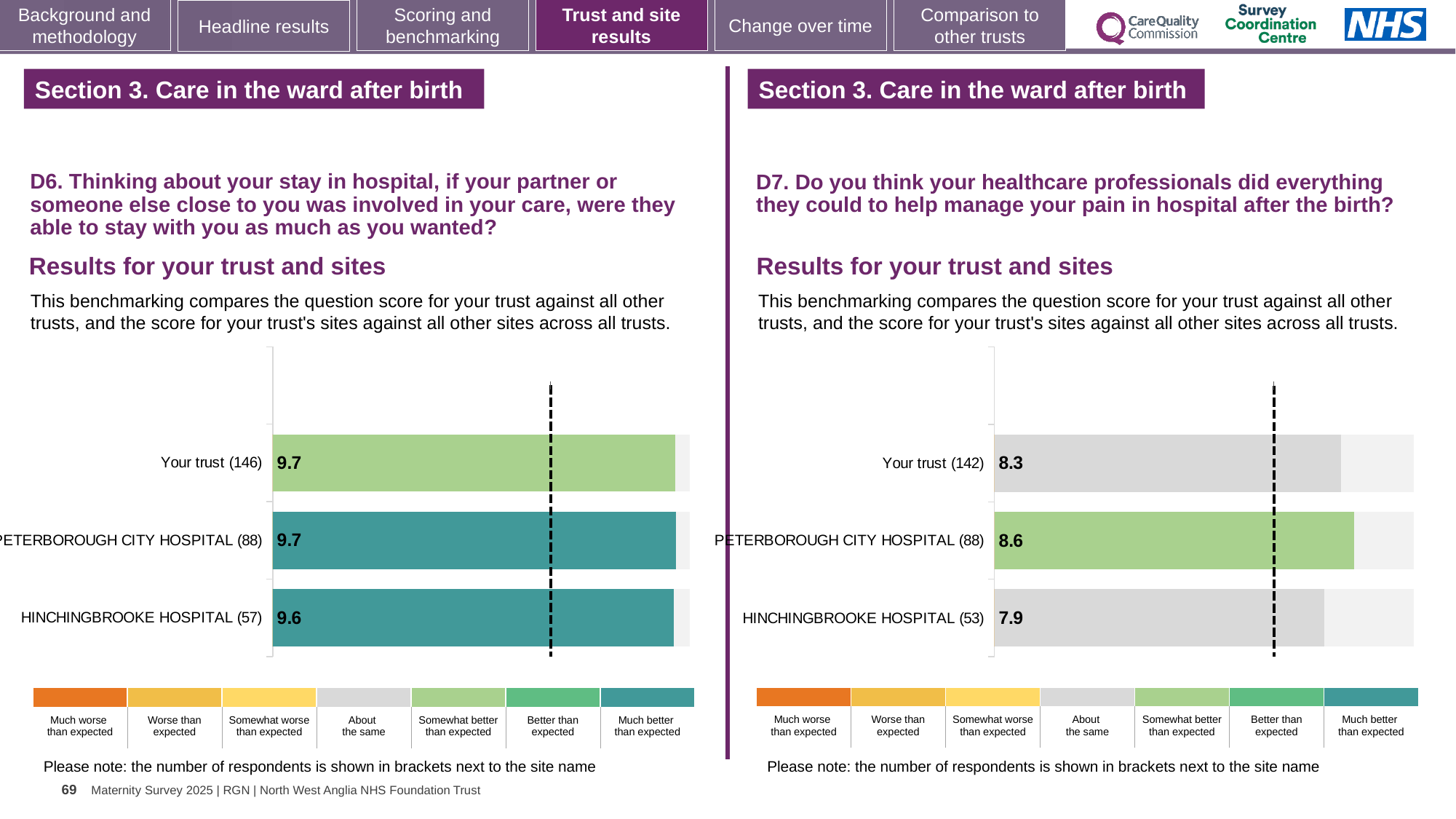
On the left chart (D6), which site has the lowest score? HINCHINGBROOKE HOSPITAL (57) On the right chart (D7), what is the score for Your trust (142)? 8.3 On the left chart (D6), what is the score for Your trust (146)? 9.7 How many bars are plotted on the left chart (D6)? 3 On the left chart (D6), what is the score for HINCHINGBROOKE HOSPITAL (57)? 9.6 On the right chart (D7), which site or trust has the lowest score? HINCHINGBROOKE HOSPITAL (53) On the right chart (D7), what is the score for HINCHINGBROOKE HOSPITAL (53)? 7.9 On the right chart (D7), which site or trust has the highest score? PETERBOROUGH CITY HOSPITAL (88) On the right chart (D7), which has the larger score, Your trust (142) or HINCHINGBROOKE HOSPITAL (53)? Your trust (142) On the right chart (D7), what is the score for PETERBOROUGH CITY HOSPITAL (88)? 8.6 What type of chart is used on the right (D7)? Bar chart On the right chart (D7), what is the difference between the scores for PETERBOROUGH CITY HOSPITAL (88) and HINCHINGBROOKE HOSPITAL (53)? 0.7